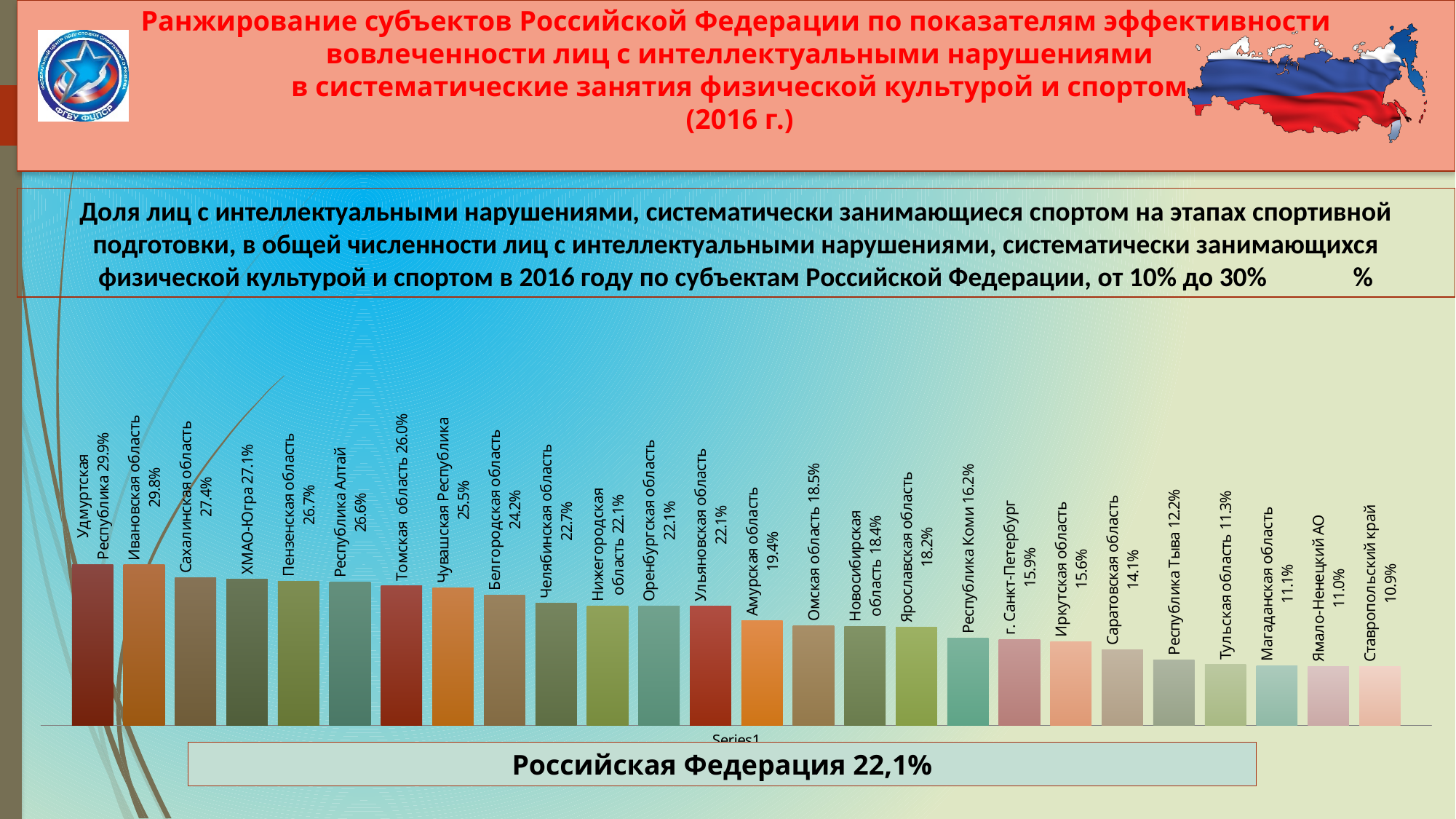
What is the difference between the values for Удмуртская Республика and Ставропольский край? 19.0 percentage points Which has a larger value, Пензенская область or Омская область? Пензенская область What is the value shown for Амурская область? 19.4% Which region has the lowest value in the chart? Ставропольский край What is the value shown for Республика Коми? 16.2% How many regions (bars) are plotted in the chart? 26 What value is given for the Российская Федерация in the box below the chart? 22,1% Which region has the highest value in the chart? Удмуртская Республика What is the value shown for Сахалинская область? 27.4% Do the values rise or fall moving from left to right along the x axis? Fall What is the value shown for Республика Тыва? 12.2% What type of chart is shown on the slide? Bar chart